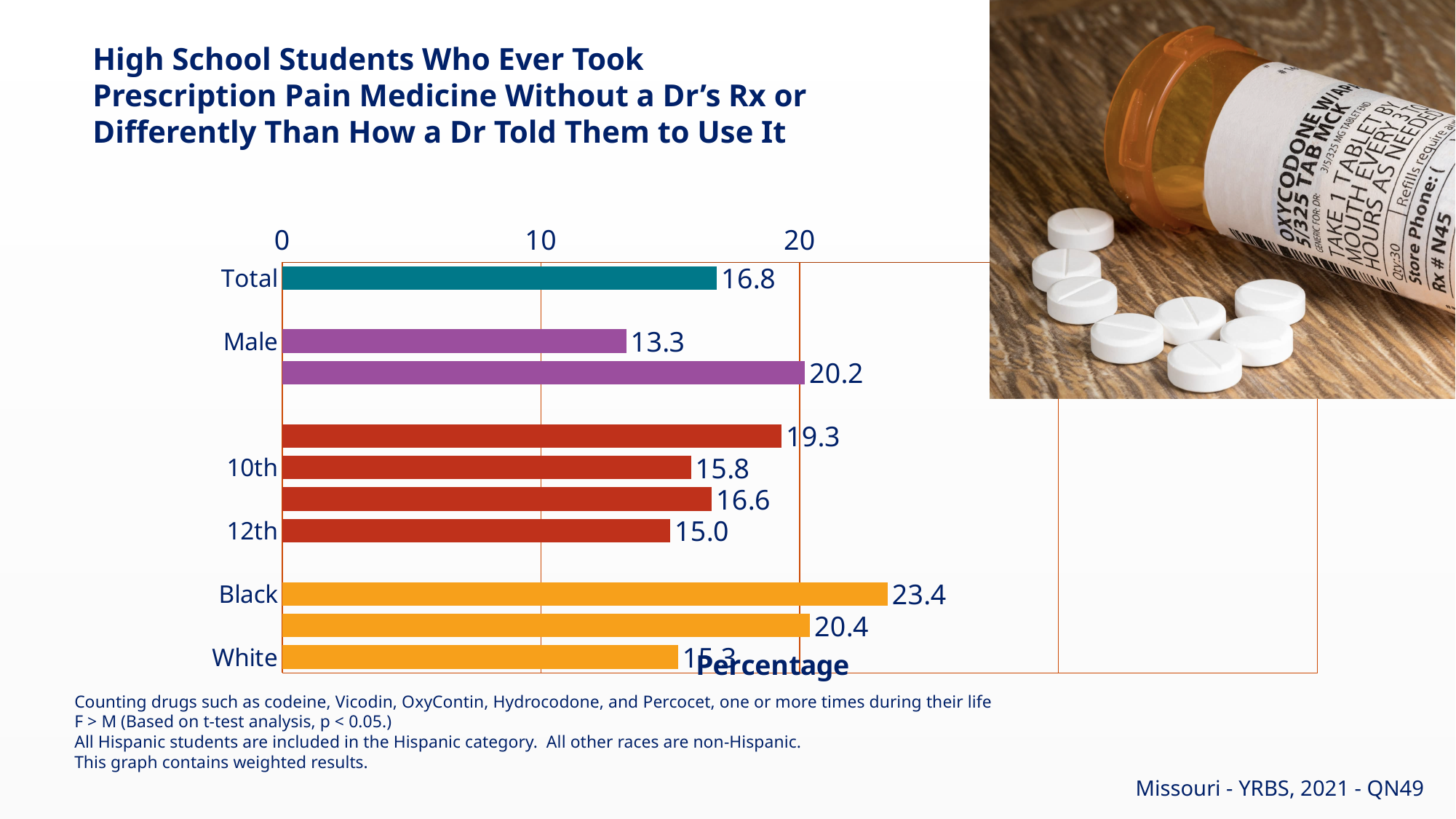
What is the difference between the values for Black and Total? 6.6 What is the value for Total? 16.8 Which labeled category has the lowest value? Male What is the value for 10th? 15.8 What is the difference between the values for 10th and 12th? 0.8 What is the value for Male? 13.3 What is the value for 12th? 15.0 Which is larger, the value for Total or the value for 10th? Total Which labeled category has the highest value? Black What kind of chart is shown on the slide? bar chart Is the value for White greater or less than 20? less What is the value for Black? 23.4